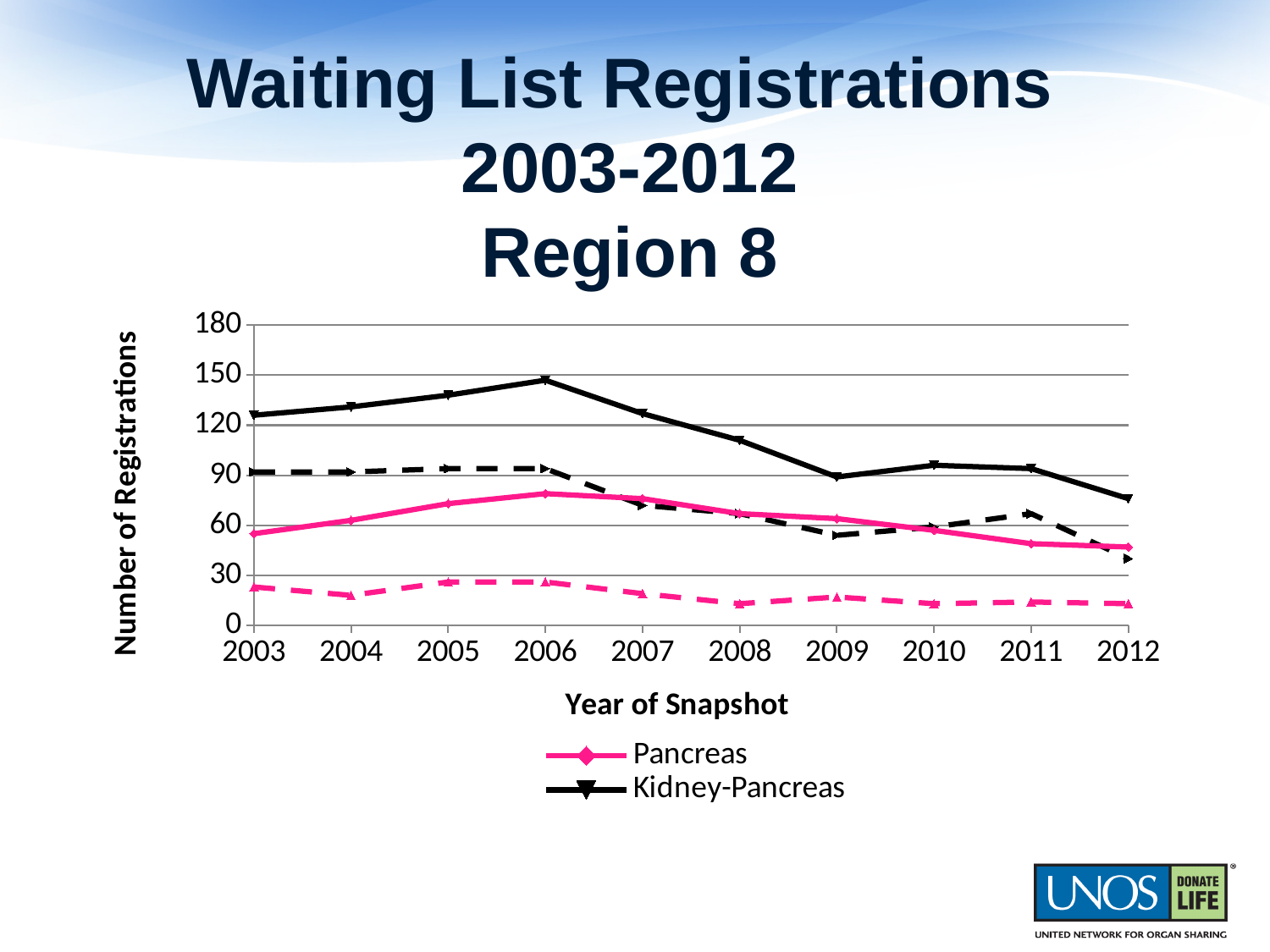
In which year does the Pancreas series reach its lowest value? 2012 How many series does the legend list? 2 In 2006, which series has the larger value, Pancreas or Kidney-Pancreas? Kidney-Pancreas In which year does the Pancreas series reach its highest value? 2006 Is the Kidney-Pancreas value for 2006 greater or less than 120? greater Does the Kidney-Pancreas series rise or fall from 2006 to 2009? fall In which year does the Kidney-Pancreas series reach its highest value? 2006 Is the Pancreas value for 2012 greater or less than 60? less In which year does the Kidney-Pancreas series reach its lowest value? 2012 What kind of chart is shown on the slide? line chart How many years are shown on the x axis? 10 Is the Kidney-Pancreas value for 2012 greater or less than 90? less